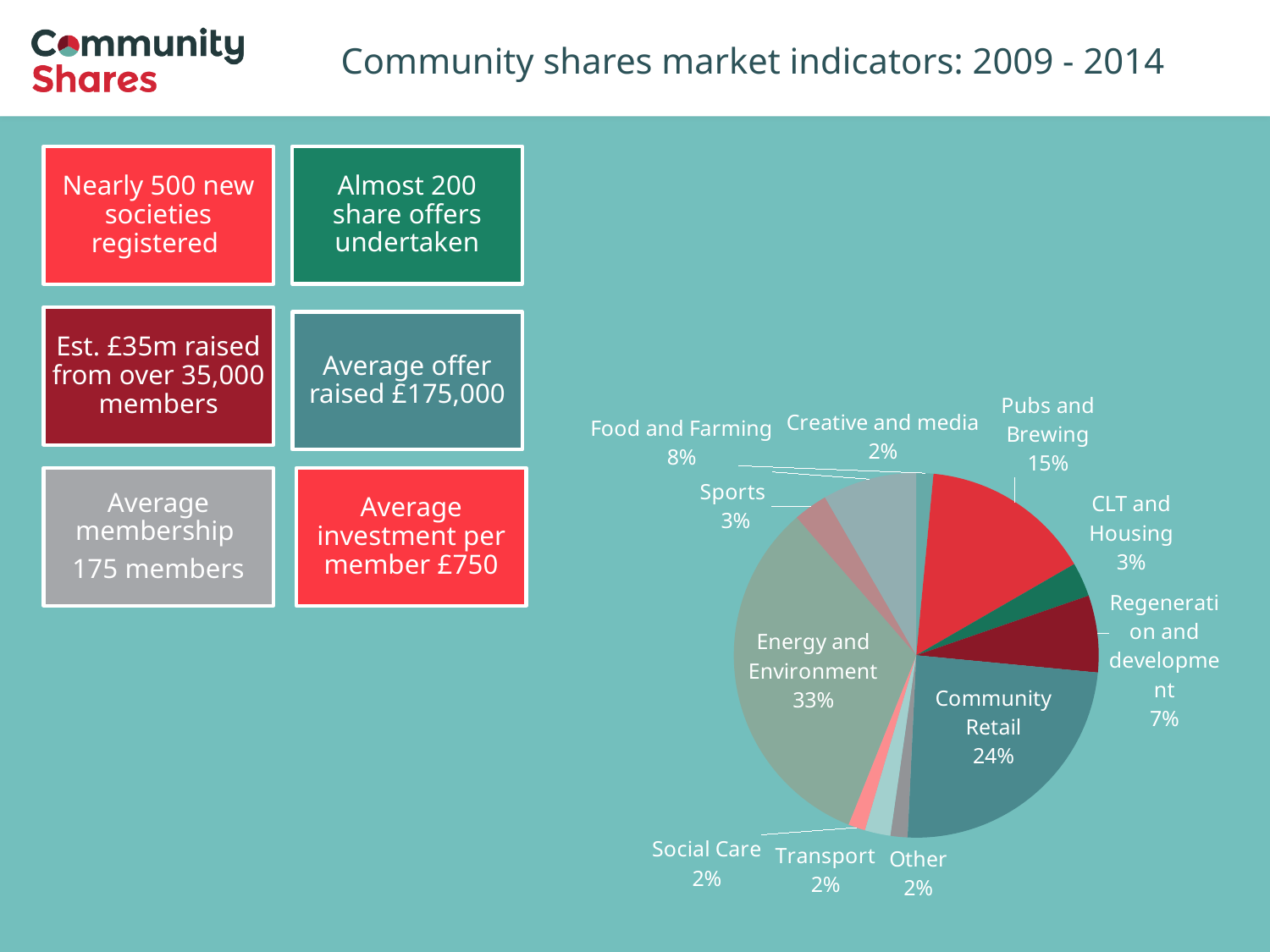
What is the difference between Energy and Environment and Community Retail? 9% What is the difference between Pubs and Brewing and CLT and Housing? 12% How many categories are shown in the pie chart? 11 What is the value for Pubs and Brewing? 15% Which is larger, Pubs and Brewing or Food and Farming? Pubs and Brewing What kind of chart is shown on the slide? pie chart What is the value for Community Retail? 24% What is the value for Food and Farming? 8% What is the value for Sports? 3% Which category has the largest slice of the pie? Energy and Environment What is the value for Regeneration and development? 7% What share of the pie does Energy and Environment have? 33%